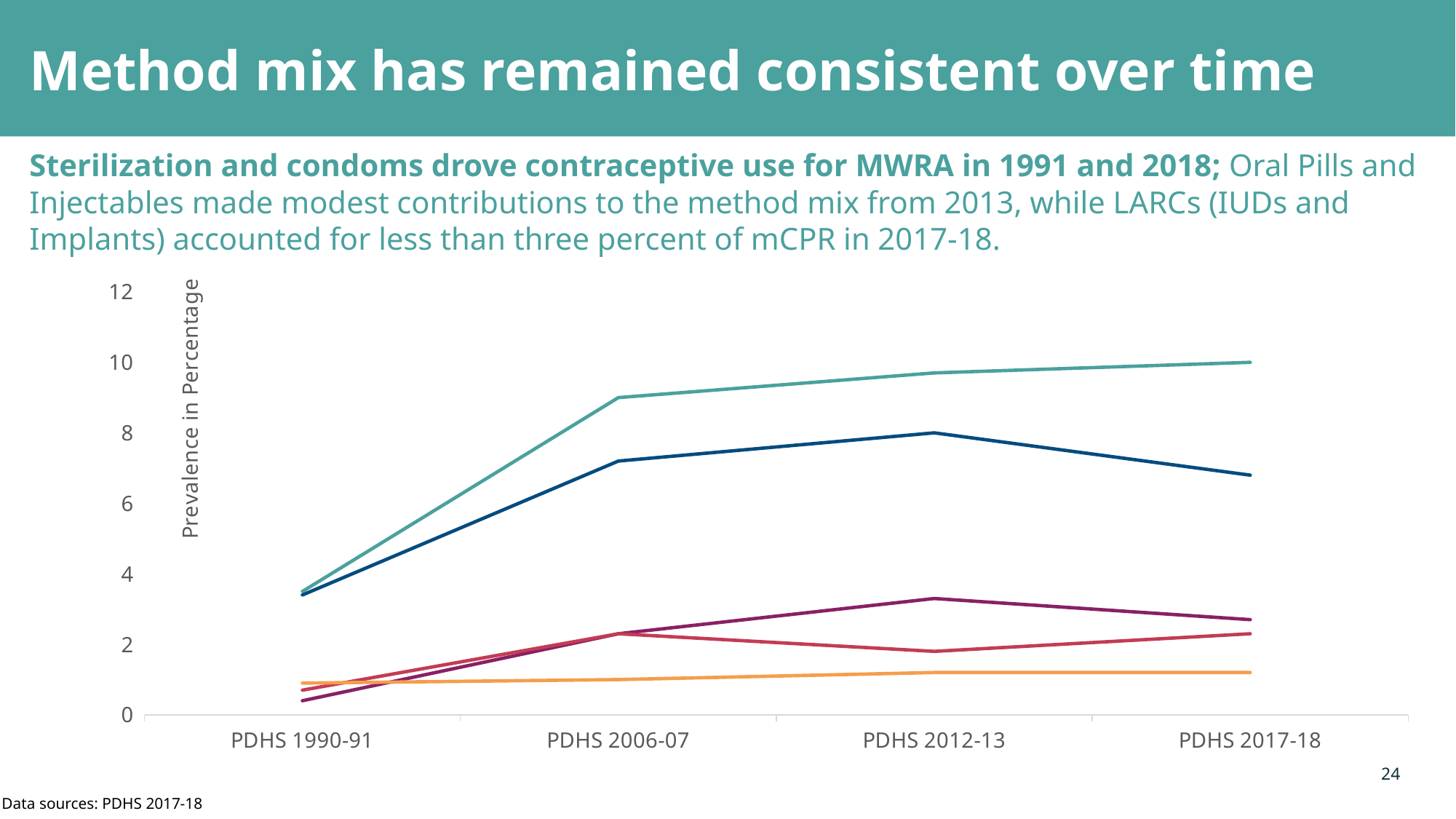
Is the value of the dark blue line at PDHS 2017-18 greater or less than 8? less At which survey round is the purple line at its lowest value? PDHS 1990-91 What is the title of the vertical axis? Prevalence in Percentage At which survey round does the dark blue line reach its highest value? PDHS 2012-13 What kind of chart is shown on the slide? line chart Is the value of the purple line at PDHS 2012-13 greater or less than 2? greater How many lines are plotted on the chart? 5 How many survey rounds (categories) are shown on the x axis? 4 At PDHS 2017-18, which line is higher: the light teal line or the dark blue line? the light teal line Is the value of the orange line at PDHS 2017-18 greater or less than 2? less Does the light teal line rise or fall from PDHS 1990-91 to PDHS 2017-18? rise